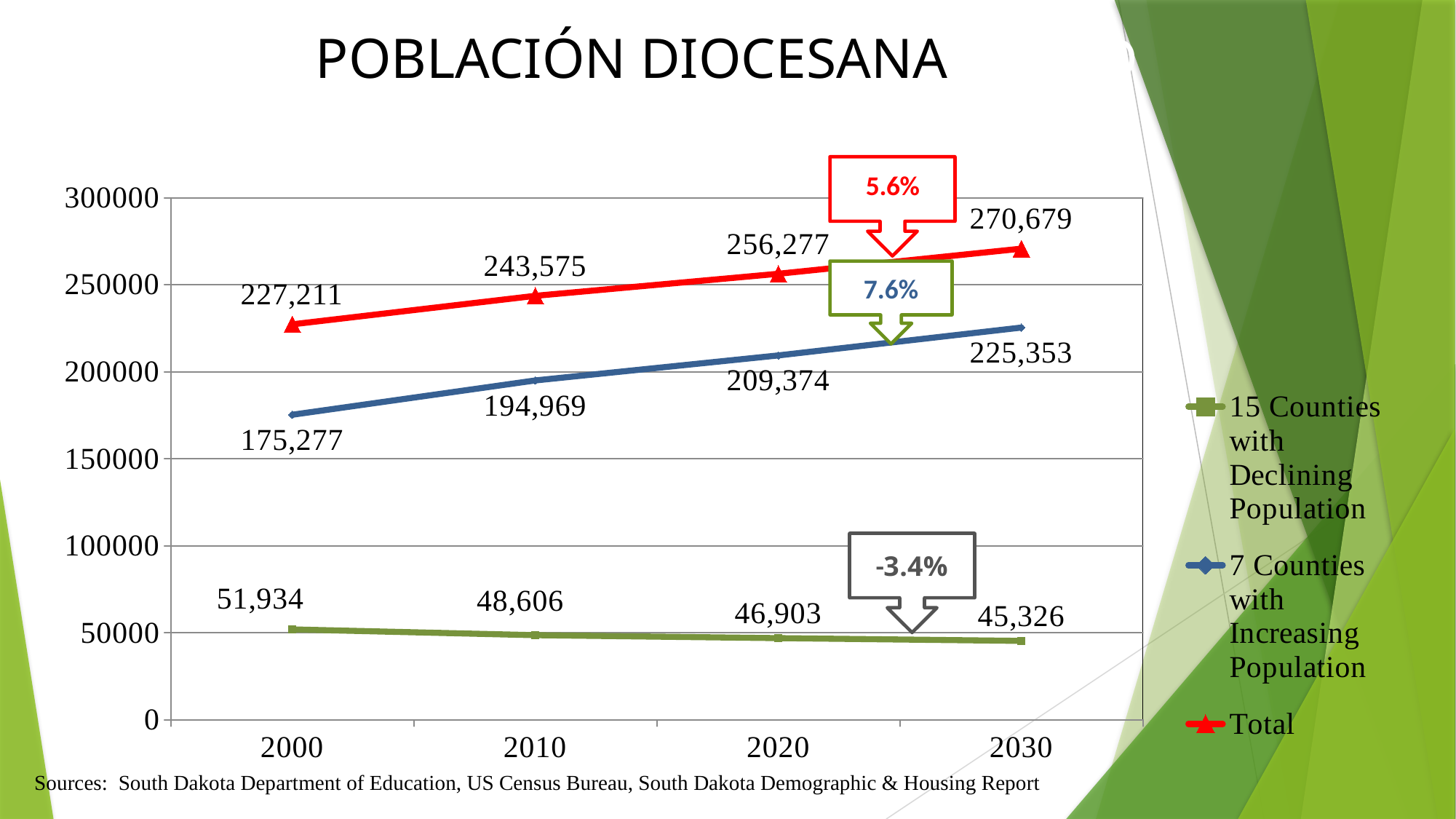
What is the value for the 15 Counties with Declining Population series in 2020? 46,903 Does the 15 Counties with Declining Population series rise or fall from 2000 to 2030? fall How many years are shown on the x axis? 4 What is the Total population value for 2030? 270,679 What is the difference between the Total values for 2030 and 2020? 14,402 How many series does the legend list? 3 What kind of chart is shown on the slide? line chart What is the value for the 7 Counties with Increasing Population series in 2000? 175,277 Is the value for the 7 Counties with Increasing Population series in 2030 greater or less than 200000? greater In which year is the 15 Counties with Declining Population series at its highest? 2000 In which year is the Total series at its lowest? 2000 Which is larger: the 7 Counties with Increasing Population value in 2010 or in 2020? 2020